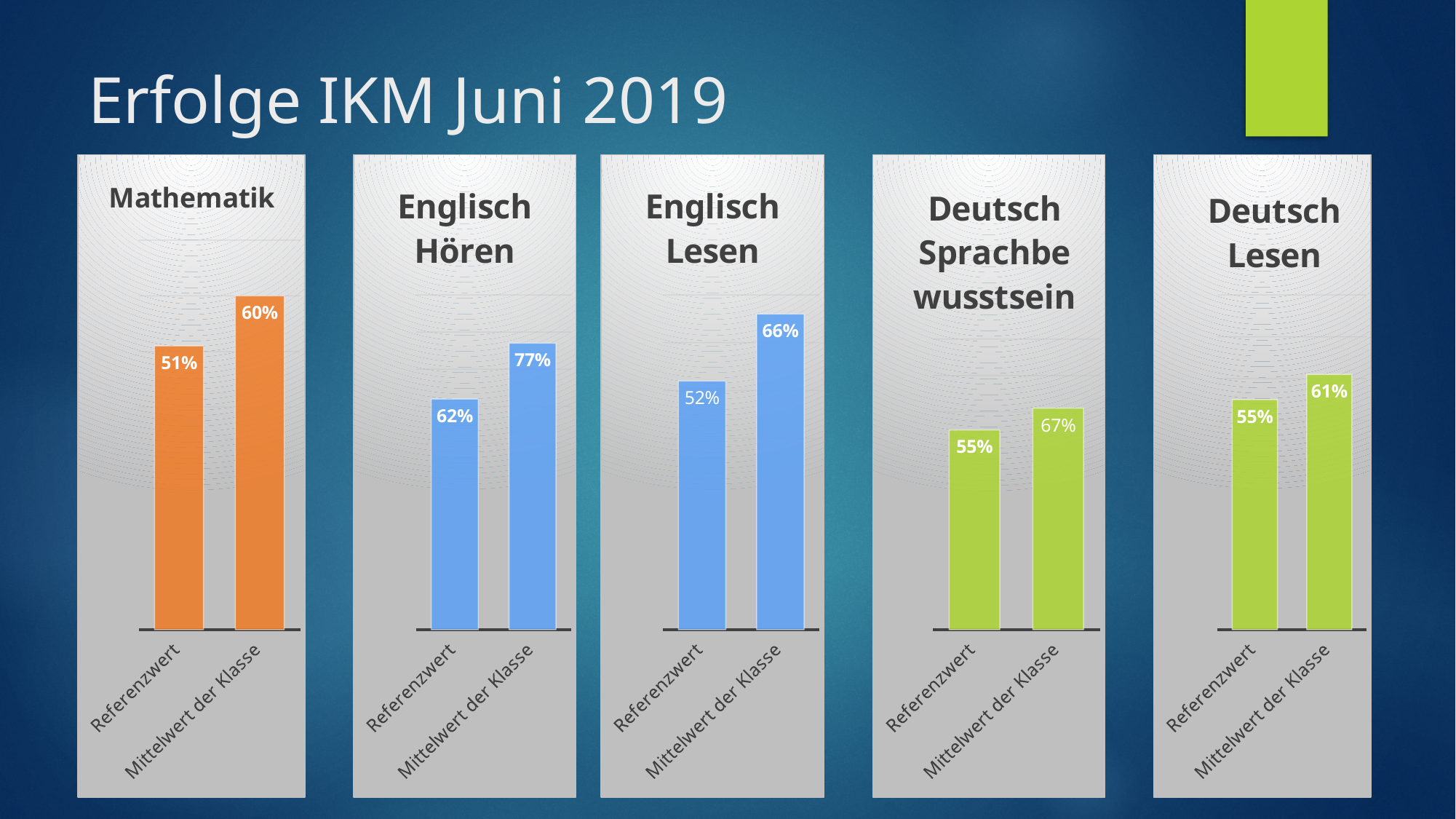
What kind of chart is the Englisch Hören chart? Bar chart In the Deutsch Lesen chart, what is the value for Referenzwert? 55% In the Englisch Lesen chart, what is the value for Referenzwert? 52% In the Mathematik chart, what is the value for Referenzwert? 51% In the Deutsch Lesen chart, which is larger, Referenzwert or Mittelwert der Klasse? Mittelwert der Klasse In the Englisch Hören chart, what is the difference between Mittelwert der Klasse and Referenzwert? 15% In the Englisch Hören chart, what is the value for Mittelwert der Klasse? 77% In the Mathematik chart, which category has the highest value? Mittelwert der Klasse In the Mathematik chart, what is the value for Mittelwert der Klasse? 60% In the Englisch Lesen chart, what is the difference between Mittelwert der Klasse and Referenzwert? 14% In the Deutsch Sprachbewusstsein chart, what is the value for Mittelwert der Klasse? 67% How many bars does the Deutsch Sprachbewusstsein chart show? 2